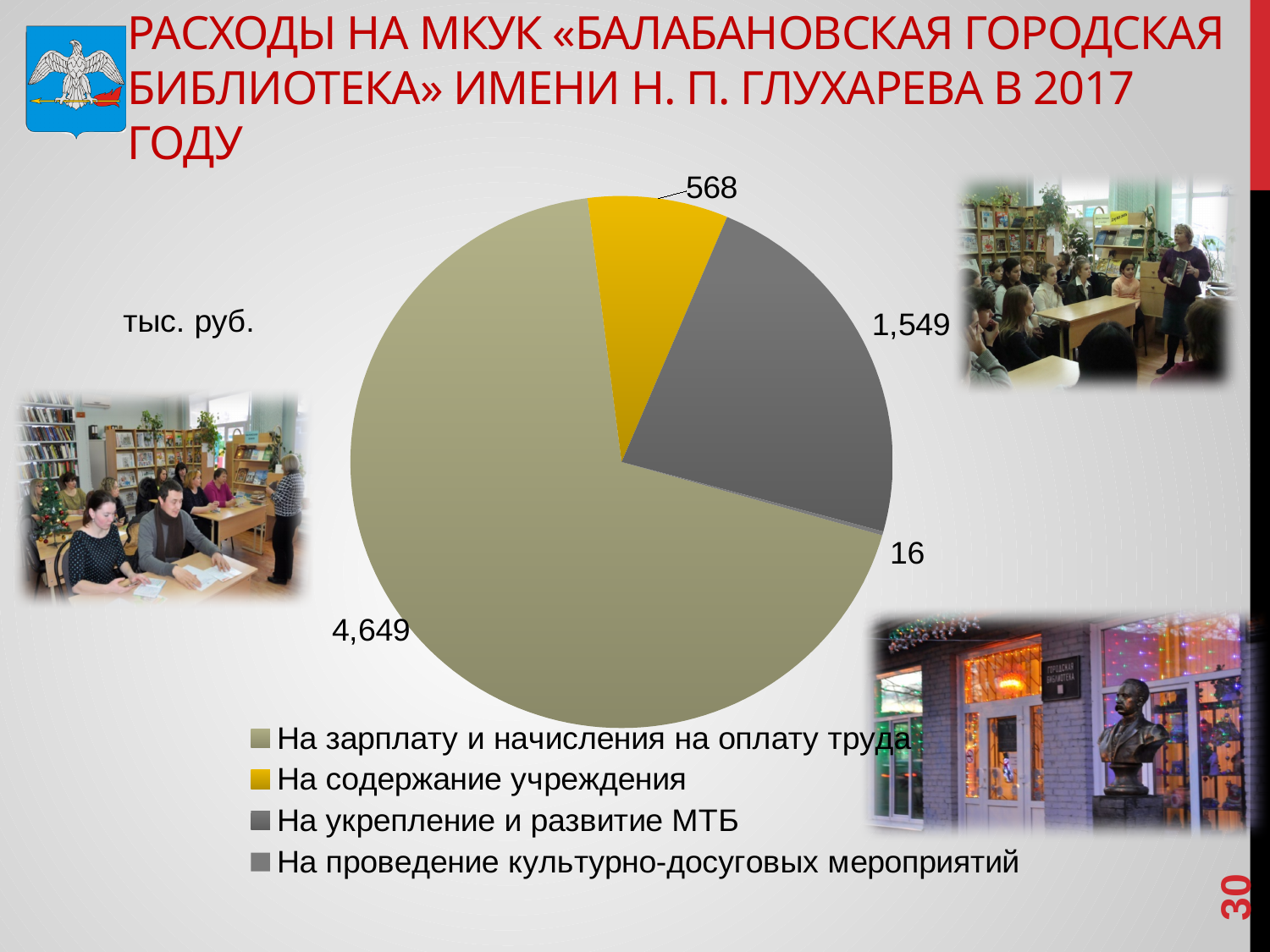
What is the value for «На проведение культурно-досуговых мероприятий»? 16 What kind of chart is shown on the slide? pie chart Which is larger: the value for «На укрепление и развитие МТБ» or for «На содержание учреждения»? На укрепление и развитие МТБ Which category has the smallest slice of the pie? На проведение культурно-досуговых мероприятий What is the value for «На зарплату и начисления на оплату труда»? 4,649 How many slices does the pie chart have? 4 What unit of measurement is indicated for the values on the chart? тыс. руб. What is the value for «На укрепление и развитие МТБ»? 1,549 What is the value for «На содержание учреждения»? 568 How many entries does the legend list? 4 Which category has the largest slice of the pie? На зарплату и начисления на оплату труда What is the difference between the values for «На зарплату и начисления на оплату труда» and «На укрепление и развитие МТБ»? 3,100